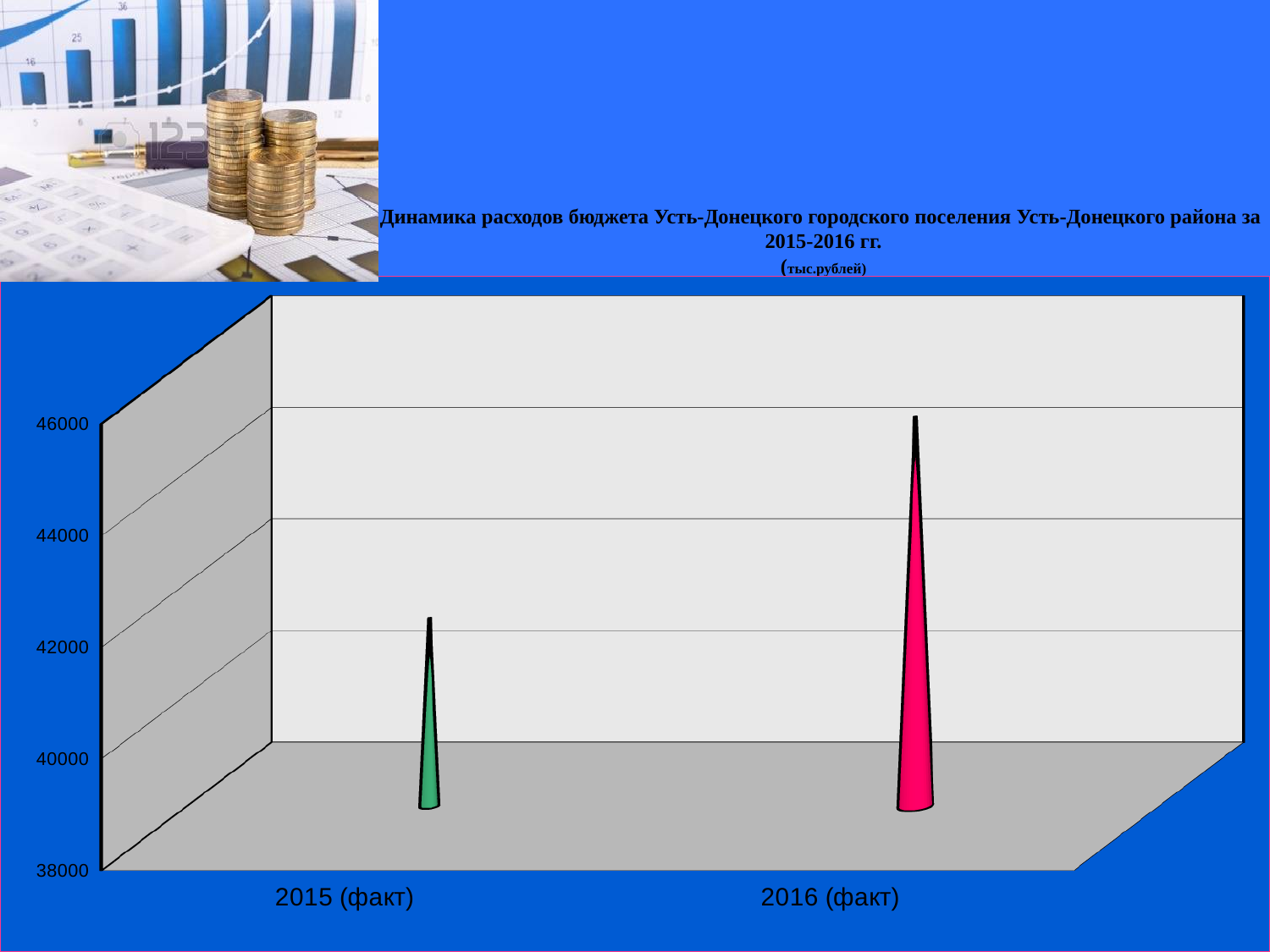
Which category has the lowest value on the chart? 2015 (факт) What colour is the bar for 2015 (факт)? green Is the value for 2016 (факт) greater or less than 44000? greater Do the values rise or fall from 2015 (факт) to 2016 (факт)? rise In what units are the values on the chart expressed, according to the title? тыс.рублей Which is larger, the value for 2015 (факт) or the value for 2016 (факт)? 2016 (факт) Is the value for 2015 (факт) greater or less than 40000? greater How many categories are plotted on the chart? 2 Is the value for 2015 (факт) greater or less than 44000? less Which category has the highest value on the chart? 2016 (факт) What kind of chart is shown on the slide? bar chart